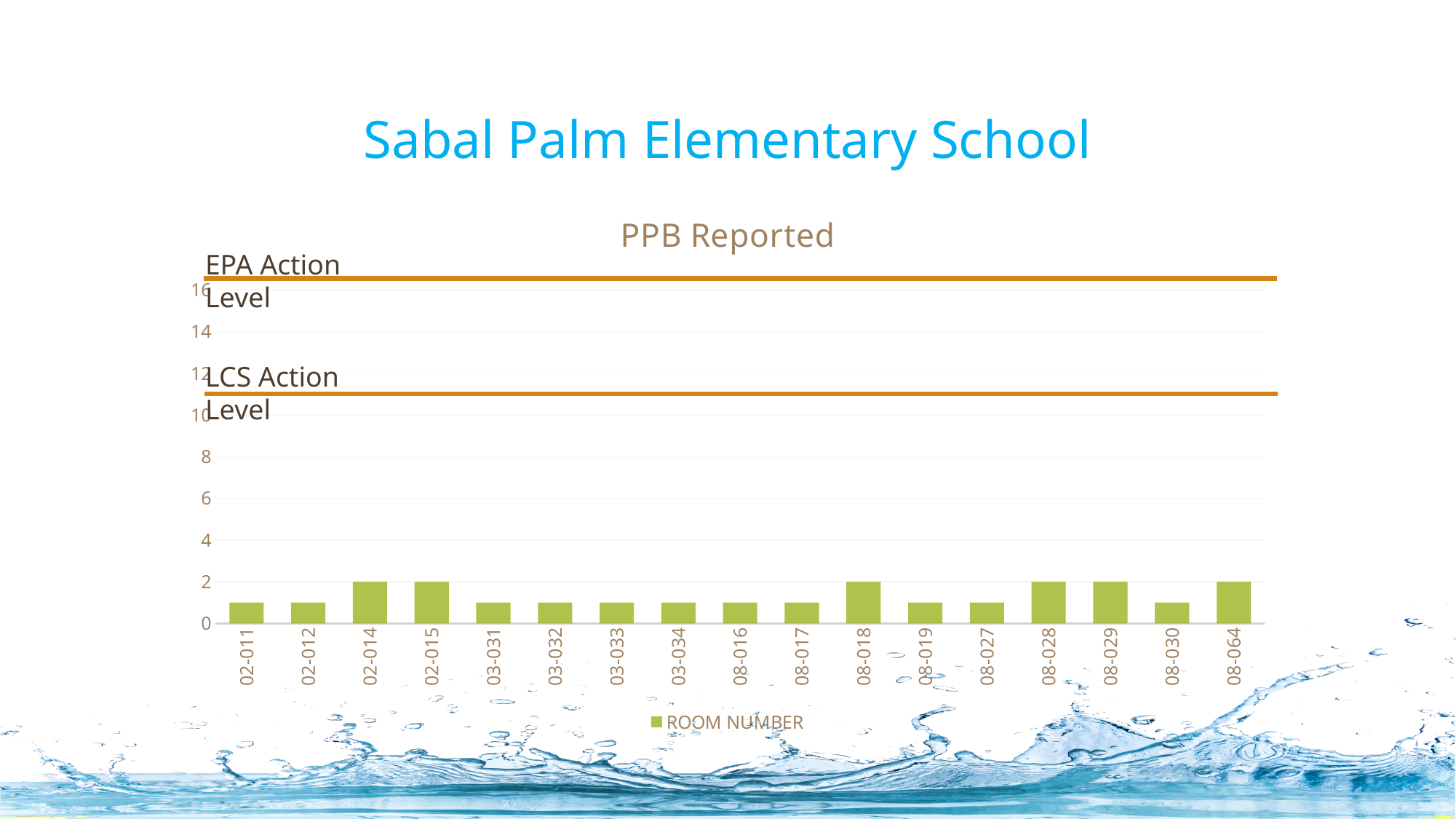
Is the value for room 08-018 greater or less than 10? less Which is larger, the value for room 08-019 or the value for room 08-029? 08-029 What kind of chart is shown on the slide? bar chart What is the value for room 08-028? 2 Is the value for room 02-011 greater or less than 2? less Which is larger, the value for room 02-015 or the value for room 03-031? 02-015 What is the title of the chart? PPB Reported What is the value for room 02-014? 2 What is the value for room 08-064? 2 What is the legend entry for the plotted series? ROOM NUMBER How many room numbers (categories) are plotted on the x axis? 17 How many series does the legend list? 1